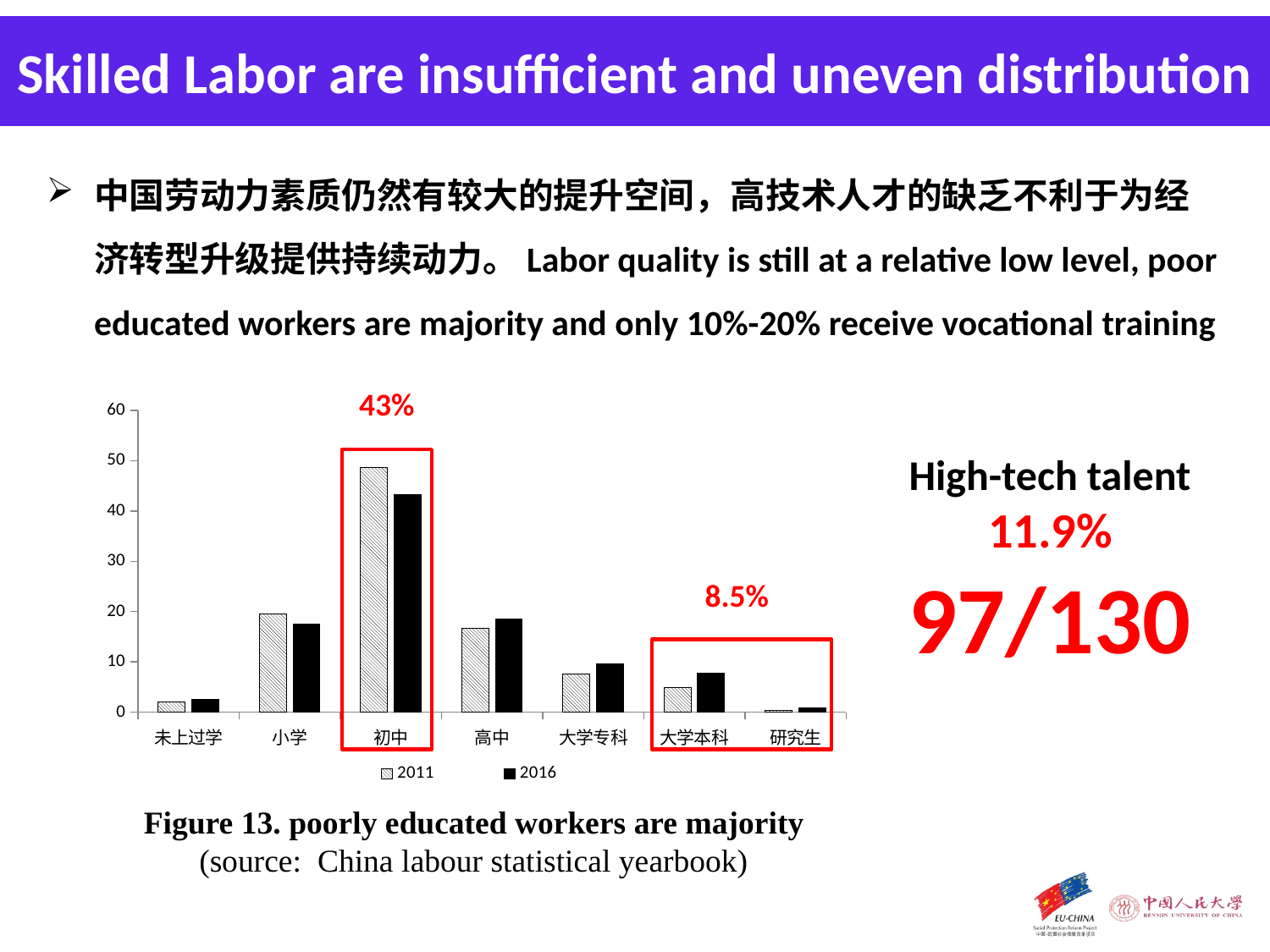
How many education categories are shown on the x axis of the chart? 7 Is the 2011 value for 初中 greater or less than 40? greater Which series does the chart legend list besides 2011? 2016 Which education category has the lowest value for the 2011 series? 研究生 Is the 2016 value for 高中 greater or less than 20? less What kind of chart is shown on the slide? bar chart Which education category has the highest value for the 2016 series? 初中 Do the 2016 values rise or fall along the x axis from 初中 to 研究生? fall How many series does the chart legend list? 2 For 大学本科, which series has the larger value, 2011 or 2016? 2016 For 初中, which series has the larger value, 2011 or 2016? 2011 Is the 2016 value for 大学本科 greater or less than 10? less